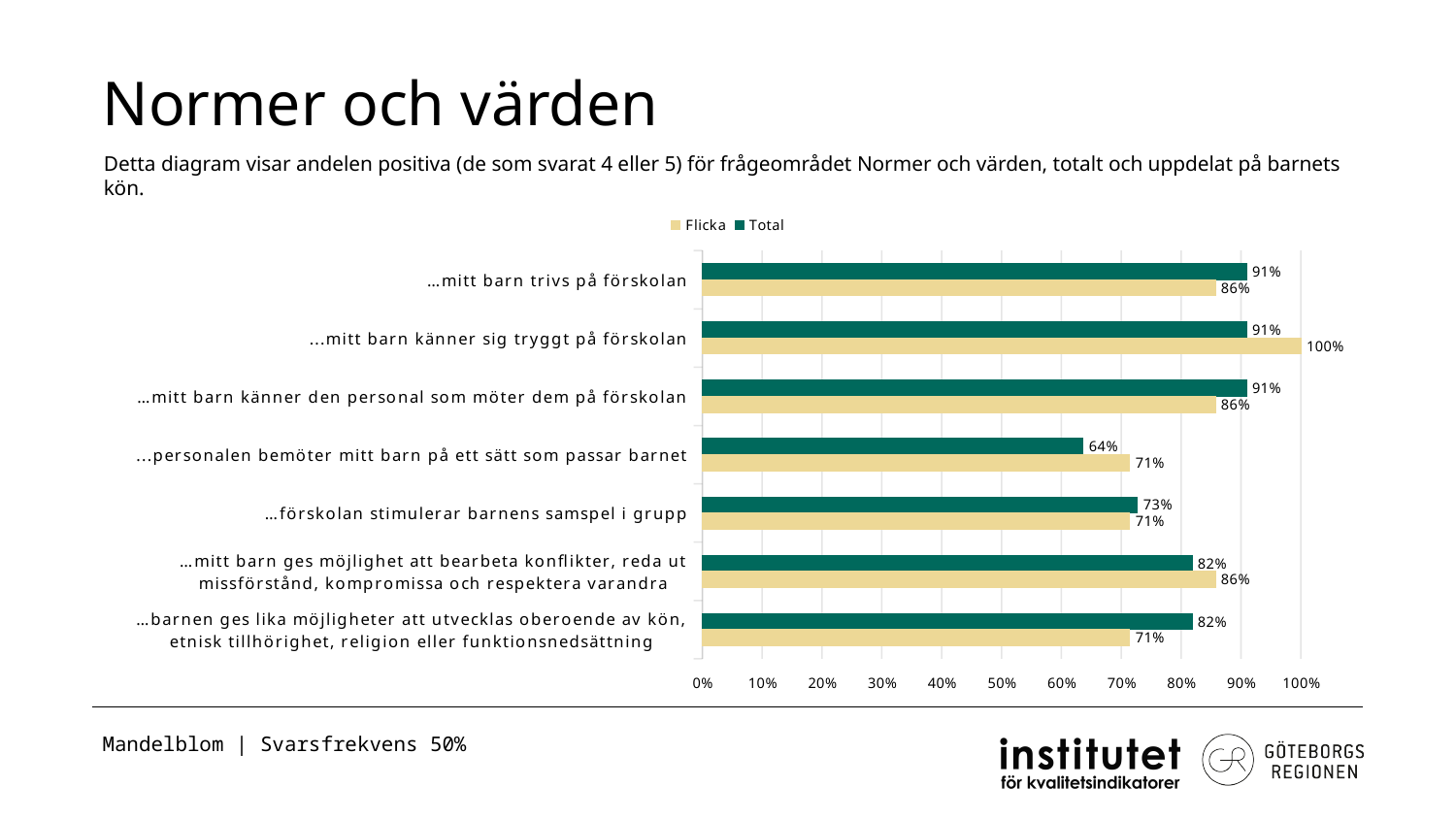
Which category has the highest Flicka value? ...mitt barn känner sig tryggt på förskolan How many series does the legend list? 2 What is the Total value for "...personalen bemöter mitt barn på ett sätt som passar barnet"? 64% What is the difference between the Flicka and Total values for "…barnen ges lika möjligheter att utvecklas oberoende av kön, etnisk tillhörighet, religion eller funktionsnedsättning"? 11% What is the Total value for "…mitt barn trivs på förskolan"? 91% How many categories are shown in the chart? 7 Which colour represents the Total series in the chart? Green What is the Flicka value for "…barnen ges lika möjligheter att utvecklas oberoende av kön, etnisk tillhörighet, religion eller funktionsnedsättning"? 71% Which category has the lowest Total value? ...personalen bemöter mitt barn på ett sätt som passar barnet For "…mitt barn ges möjlighet att bearbeta konflikter, reda ut missförstånd, kompromissa och respektera varandra", which is larger, the Flicka value or the Total value? Flicka What kind of chart is shown on the slide? Bar chart What is the Flicka value for "...mitt barn känner sig tryggt på förskolan"? 100%